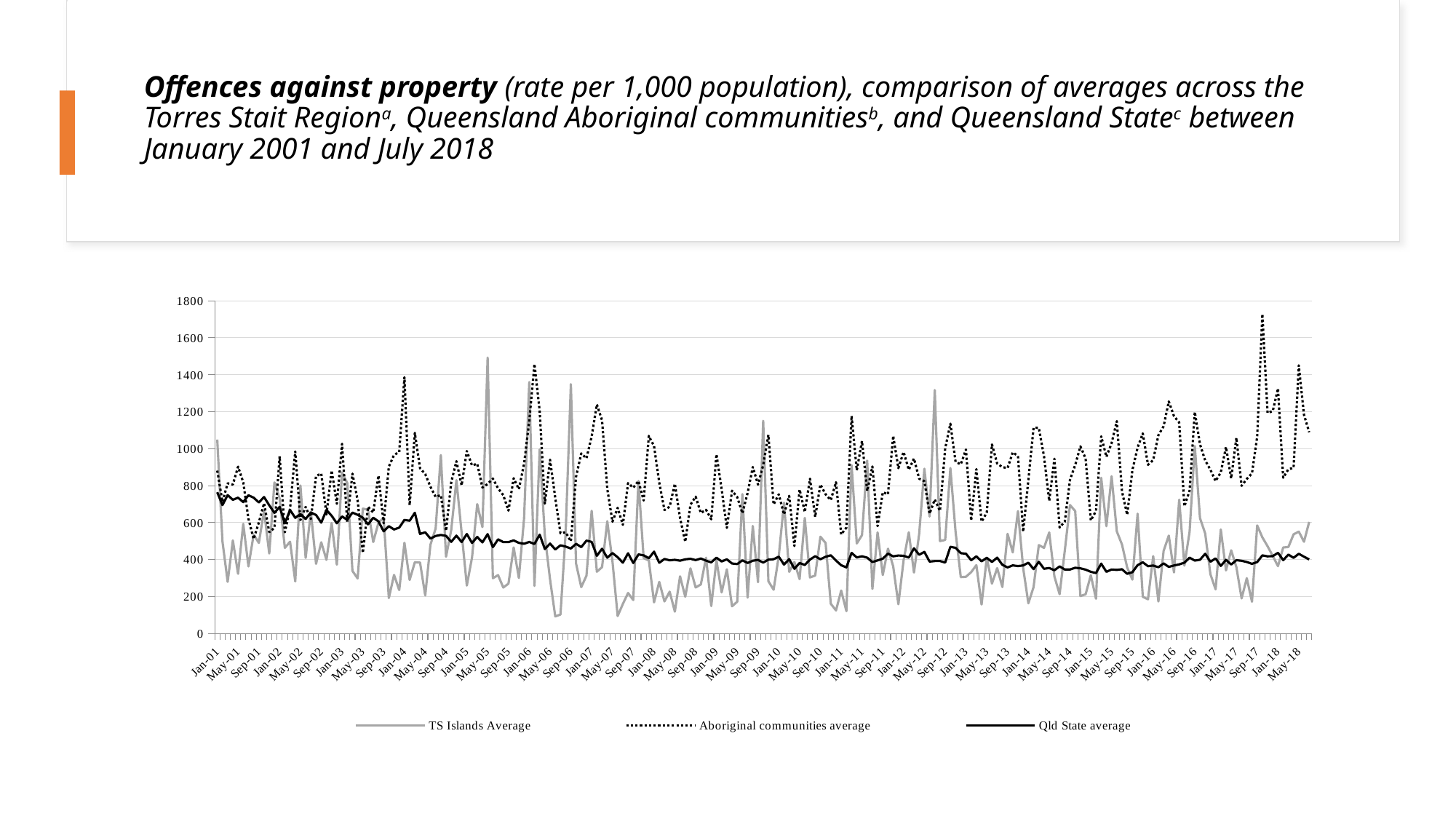
Is the TS Islands Average value at Jan-01 greater or less than 800? greater What kind of chart is shown on the slide? line chart At May-18, which is higher: the Aboriginal communities average or the Qld State average? Aboriginal communities average Is the Qld State average value at May-18 greater or less than 600? less Is the Qld State average value at Jan-01 greater or less than 600? greater Does the Qld State average series rise or fall overall from Jan-01 to May-18? fall Which series reaches the highest single value on the chart? Aboriginal communities average What are the three series named in the legend? TS Islands Average, Aboriginal communities average, Qld State average According to the title, what period does the chart cover? January 2001 to July 2018 How many series does the legend list? 3